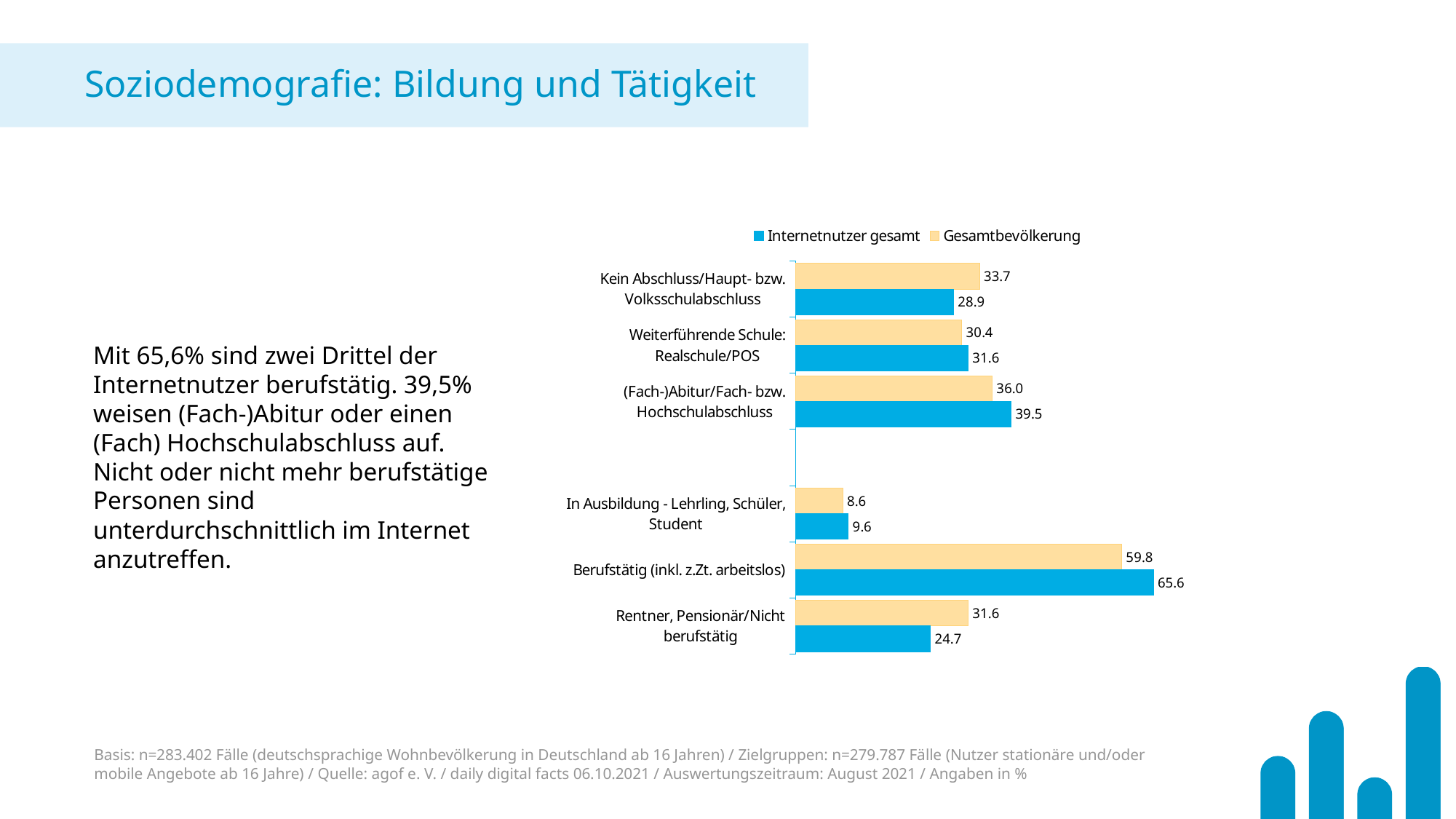
What is the value for Gesamtbevölkerung in the category In Ausbildung - Lehrling, Schüler, Student? 8.6 What kind of chart is shown on the slide? Bar chart Which category has the lowest value for Gesamtbevölkerung? In Ausbildung - Lehrling, Schüler, Student In the category Weiterführende Schule: Realschule/POS, which series has the larger value, Internetnutzer gesamt or Gesamtbevölkerung? Internetnutzer gesamt How many categories are shown on the chart? 6 What is the difference between Internetnutzer gesamt and Gesamtbevölkerung in the category Berufstätig (inkl. z.Zt. arbeitslos)? 5.8 Which category has the highest value for Internetnutzer gesamt? Berufstätig (inkl. z.Zt. arbeitslos) What is the value for Gesamtbevölkerung in the category Kein Abschluss/Haupt- bzw. Volksschulabschluss? 33.7 What is the value for Internetnutzer gesamt in the category Berufstätig (inkl. z.Zt. arbeitslos)? 65.6 How many series does the legend list? 2 What is the difference between Gesamtbevölkerung and Internetnutzer gesamt in the category Rentner, Pensionär/Nicht berufstätig? 6.9 What is the value for Internetnutzer gesamt in the category (Fach-)Abitur/Fach- bzw. Hochschulabschluss? 39.5